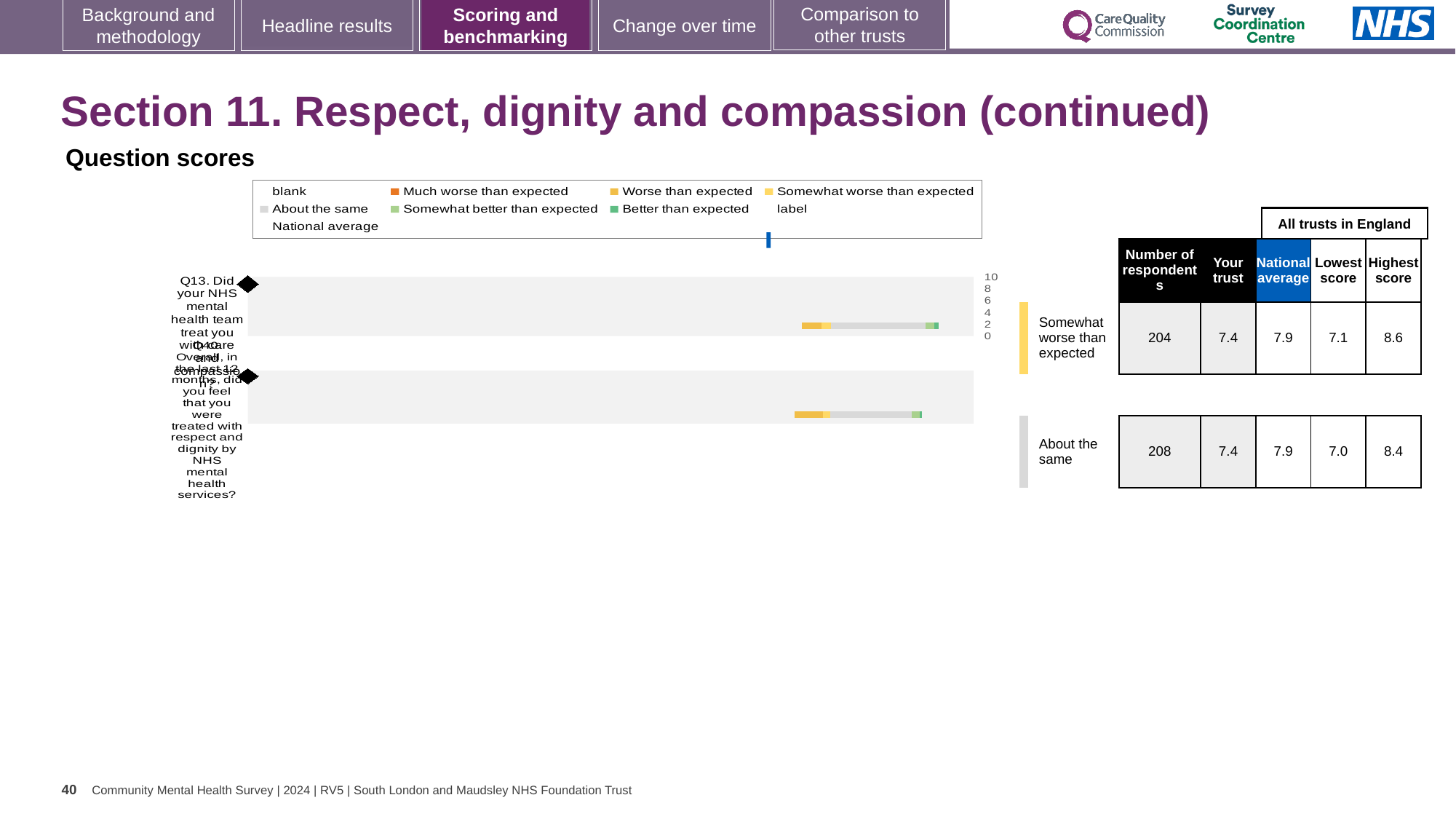
In the table beside the chart, what is the highest score among all trusts in England for Q13? 8.6 In the table beside the chart, how many respondents are listed for Q14? 208 How many questions are plotted in the question scores chart? 2 In the table beside the chart, how many respondents are listed for Q13? 204 Which question has more respondents in the table beside the chart, Q13 or Q14? Q14 In the table beside the chart, what is the national average score for Q14? 7.9 In the question scores chart legend, what colour represents 'Much worse than expected'? orange In the table beside the chart, what is the lowest score among all trusts in England for Q14? 7.0 In the table beside the chart, what is the 'Your trust' score for Q13? 7.4 In the table beside the chart, what is the difference between the highest and lowest scores for Q13? 1.5 What kind of chart is used to show the question scores for Q13 and Q14? bar chart What is the highest value shown on the score axis of the question scores chart? 10